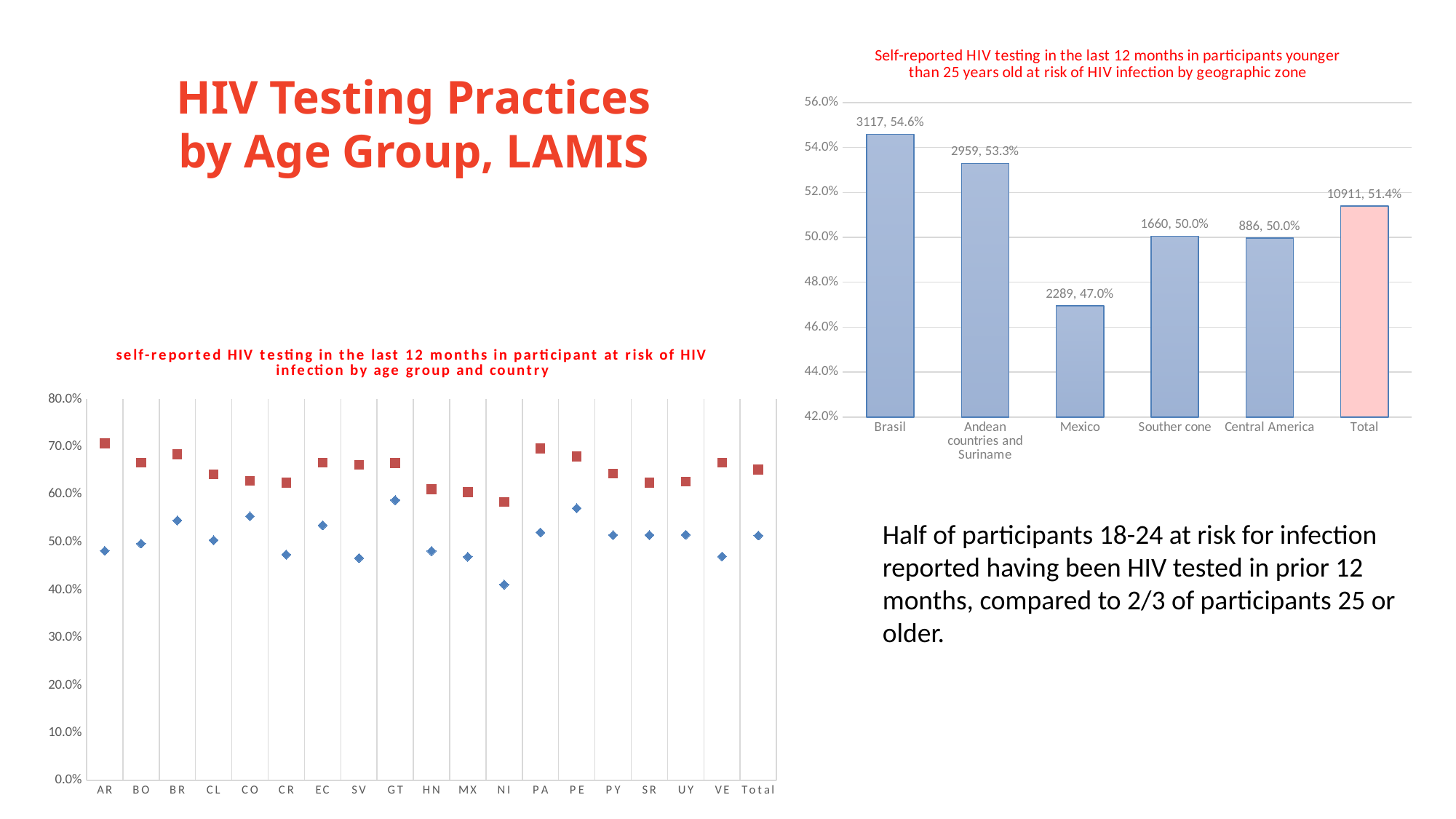
In the chart on the right, what is the value for Mexico? 47.0% In the chart on the left, is the value of the blue diamond for NI greater or less than 50.0%? less In the chart on the right, which geographic zone has the highest value? Brasil In the chart on the right, what is the difference between the values for Brasil and Mexico? 7.6% In the chart on the right, which is larger, the value for Andean countries and Suriname or the value for Souther cone? Andean countries and Suriname In the chart on the right, how many bars are plotted? 6 In the chart on the right, what is the value for the Total bar? 51.4% In the chart on the right, what is the value for Brasil? 54.6% What kind of chart is the chart on the right? Bar chart In the chart on the left, is the value of the red square for AR greater or less than 60.0%? greater In the chart on the right, which geographic zone has the lowest value? Mexico In the chart on the left, how many categories are shown on the x axis? 19